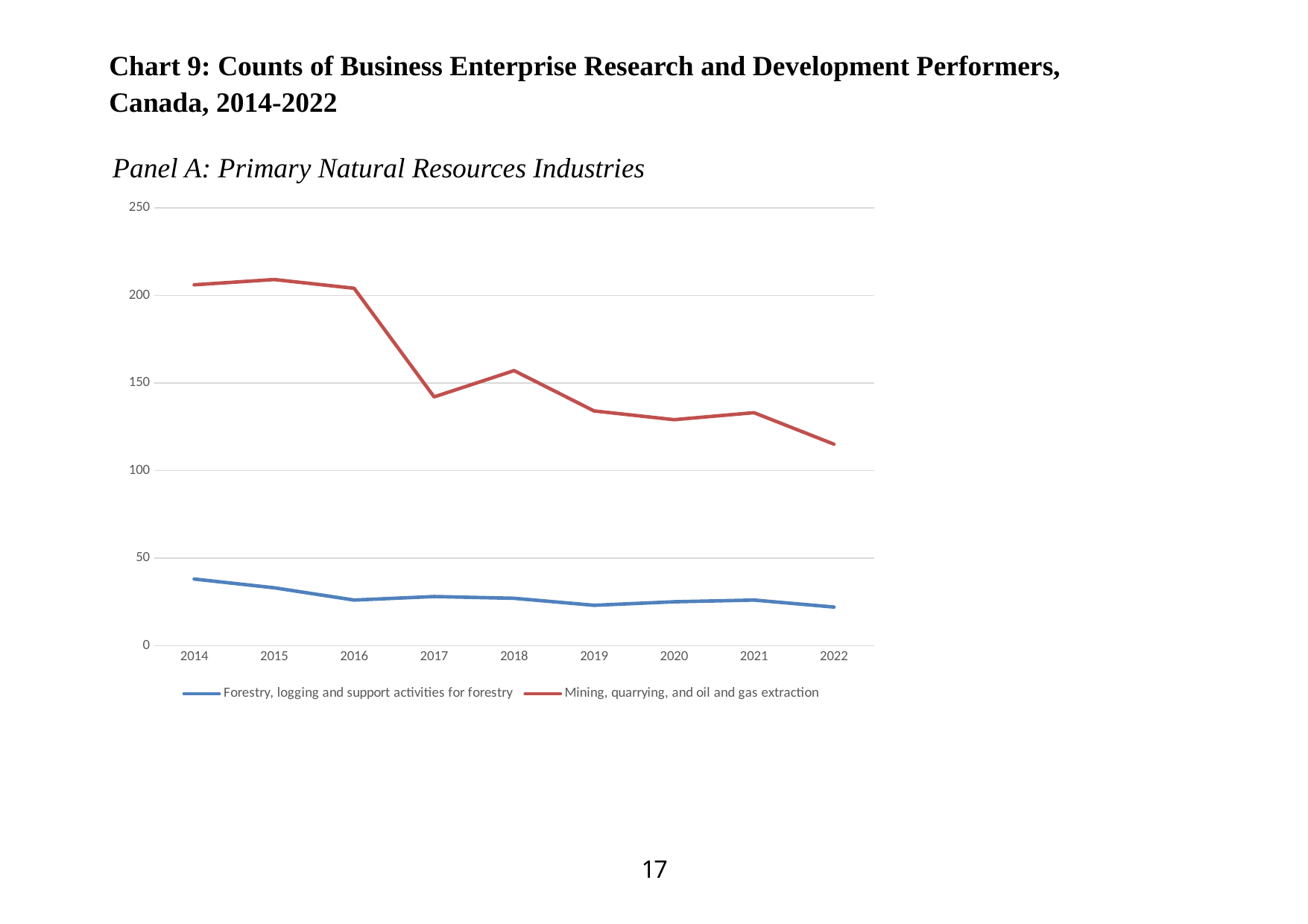
In which year does the Mining, quarrying, and oil and gas extraction series reach its lowest value? 2022 Is the value for Forestry, logging and support activities for forestry in 2014 greater or less than 50? less Is the value for Mining, quarrying, and oil and gas extraction in 2014 greater or less than 200? greater How many years are plotted along the x axis? 9 Which series has the higher value in 2018, Forestry, logging and support activities for forestry or Mining, quarrying, and oil and gas extraction? Mining, quarrying, and oil and gas extraction In which year does the Forestry, logging and support activities for forestry series reach its highest value? 2014 Overall, does the Mining, quarrying, and oil and gas extraction series rise or fall from 2014 to 2022? fall Is the value for Mining, quarrying, and oil and gas extraction in 2017 greater or less than 150? less What kind of chart is shown in Panel A? line chart What colour is the line for Forestry, logging and support activities for forestry? blue How many series does the legend list? 2